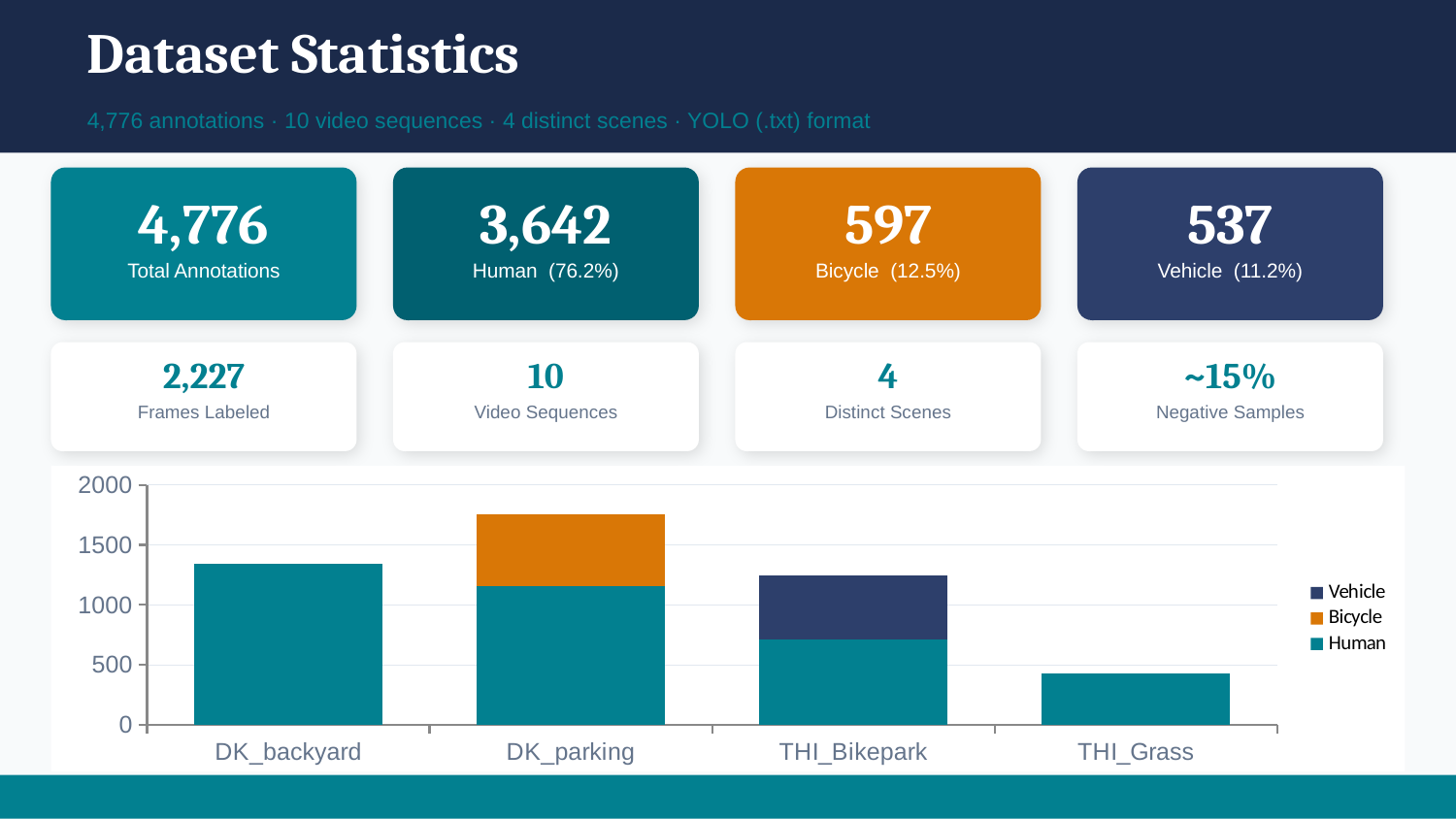
Which bar is taller, DK_backyard or THI_Bikepark? DK_backyard What kind of chart is shown at the bottom of the slide? stacked bar chart How many categories are shown on the x axis of the bar chart? 4 Is the value for THI_Grass greater or less than 500? less Is the total bar height for THI_Bikepark greater or less than 1000? greater Is the total bar height for DK_parking greater or less than 1500? greater Which category has the shortest bar in the chart? THI_Grass Which category in the chart includes a Vehicle segment? THI_Bikepark How many series does the legend of the bar chart list? 3 Which category in the chart includes a Bicycle segment? DK_parking Which category has the tallest stacked bar in the chart? DK_parking